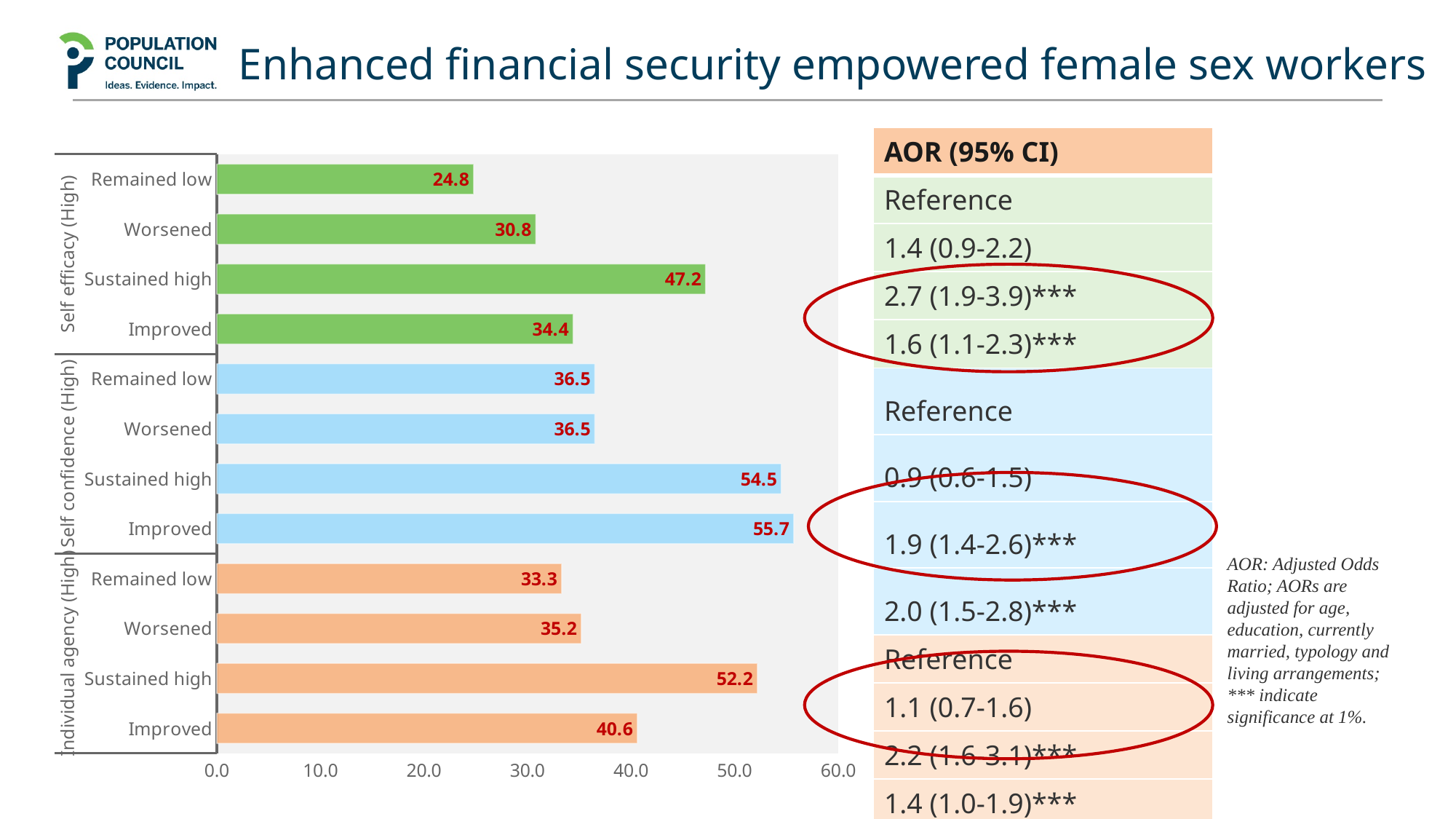
Which category has the lowest value across the whole chart? Remained low (Self efficacy) Which is larger: "Worsened" in the Self efficacy (High) group or "Worsened" in the Individual agency (High) group? Worsened in Individual agency (High) Is the value for "Improved" in the Self efficacy (High) group greater or less than 40.0? less What is the value for "Improved" in the Self confidence (High) group? 55.7 How many bars are plotted in the chart? 12 What is the difference between "Improved" and "Sustained high" in the Self confidence (High) group? 1.2 What is the difference between "Sustained high" and "Remained low" in the Individual agency (High) group? 18.9 What is the value for "Sustained high" in the Self efficacy (High) group? 47.2 What colour are the bars for the Self confidence (High) group? Light blue Which category has the highest value in the Self efficacy (High) group? Sustained high What kind of chart is shown on the slide? Bar chart What is the value for "Remained low" in the Individual agency (High) group? 33.3